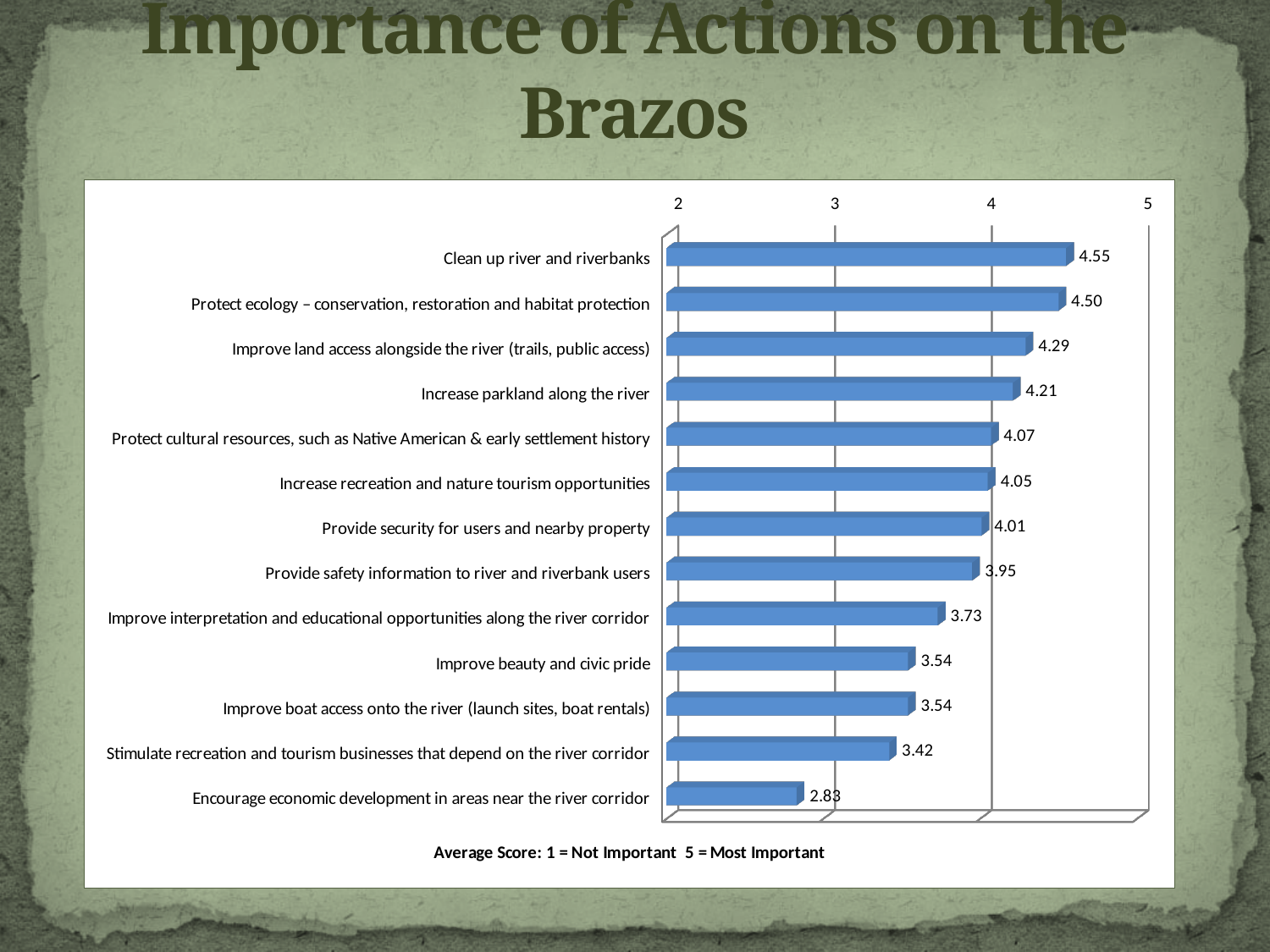
What is the difference between the average scores for "Clean up river and riverbanks" and "Encourage economic development in areas near the river corridor"? 1.72 Which has a higher average score: "Improve land access alongside the river (trails, public access)" or "Provide safety information to river and riverbank users"? Improve land access alongside the river (trails, public access) Is the average score for "Stimulate recreation and tourism businesses that depend on the river corridor" greater or less than 4? less Which action has the highest average score? Clean up river and riverbanks What is the average score for "Clean up river and riverbanks"? 4.55 How many actions are shown in the chart? 13 What kind of chart is shown on the slide? Bar chart What is the difference between the average scores for "Protect ecology – conservation, restoration and habitat protection" and "Improve beauty and civic pride"? 0.96 What is the average score for "Improve interpretation and educational opportunities along the river corridor"? 3.73 What is the average score for "Increase parkland along the river"? 4.21 According to the axis caption, what does a score of 5 represent? Most Important Which action has the lowest average score? Encourage economic development in areas near the river corridor